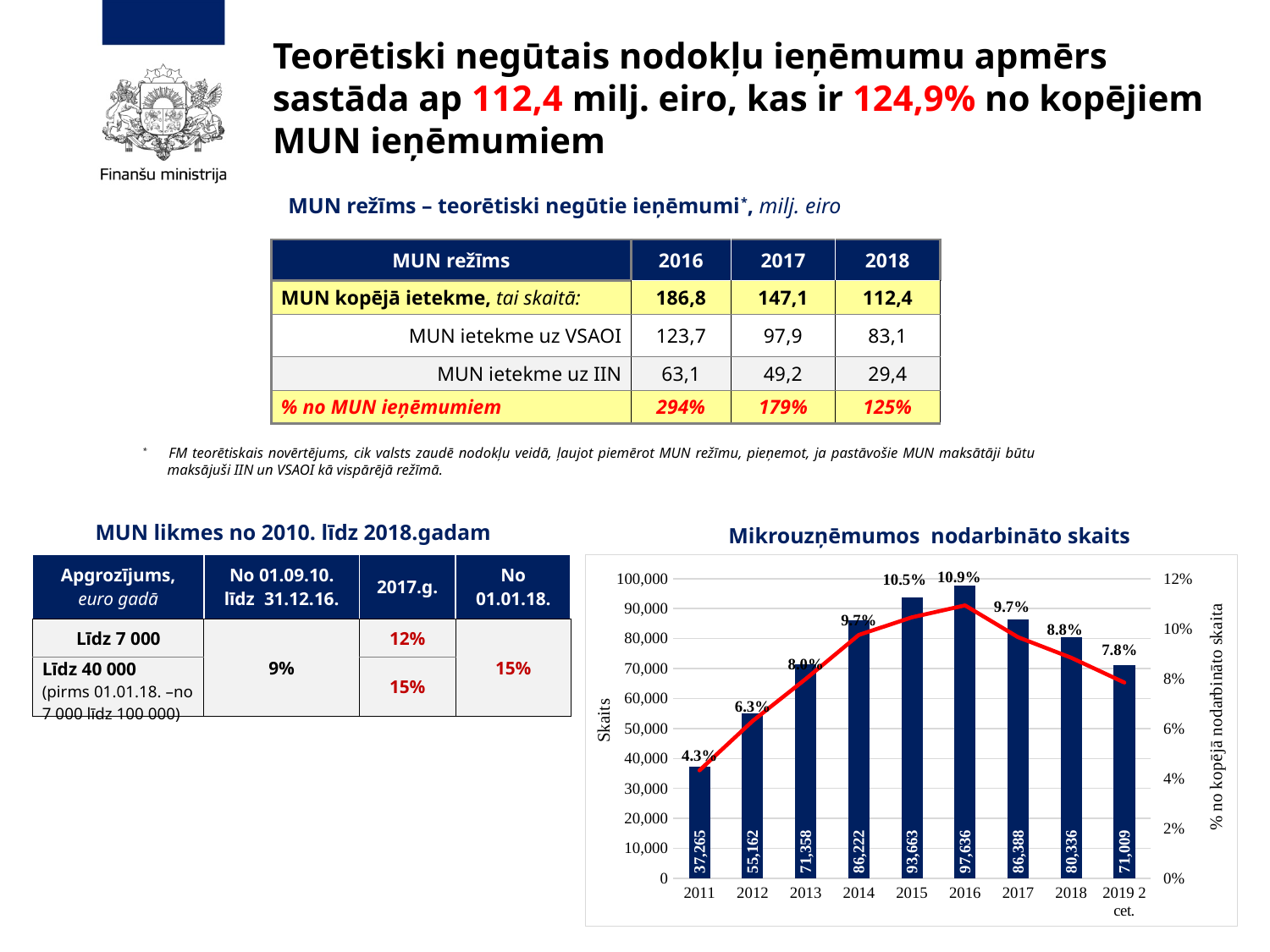
In the chart 'Mikrouzņēmumos nodarbināto skaits', what is the number of employees (Skaits) for 2016? 97,636 In the chart 'Mikrouzņēmumos nodarbināto skaits', which year has the lowest number of employees? 2011 In the chart 'Mikrouzņēmumos nodarbināto skaits', what is the difference in the number of employees between 2016 and 2018? 17,300 In the chart 'Mikrouzņēmumos nodarbināto skaits', what is the number of employees for 2011? 37,265 In the chart 'Mikrouzņēmumos nodarbināto skaits', what percentage of total employment is shown for 2019 2 cet.? 7.8% In the chart 'Mikrouzņēmumos nodarbināto skaits', what percentage of total employment is shown for 2016? 10.9% What type of chart is 'Mikrouzņēmumos nodarbināto skaits'? Bar chart with a line In the chart 'Mikrouzņēmumos nodarbināto skaits', which year has more employees, 2014 or 2017? 2017 In the chart 'Mikrouzņēmumos nodarbināto skaits', how many time periods are shown on the x axis? 9 In the chart 'Mikrouzņēmumos nodarbināto skaits', which year has the highest number of employees? 2016 In the chart 'Mikrouzņēmumos nodarbināto skaits', how does the number of employees change from 2016 to 2019 2 cet.? It falls In the chart 'Mikrouzņēmumos nodarbināto skaits', what is the title of the right-hand vertical axis? % no kopējā nodarbināto skaita